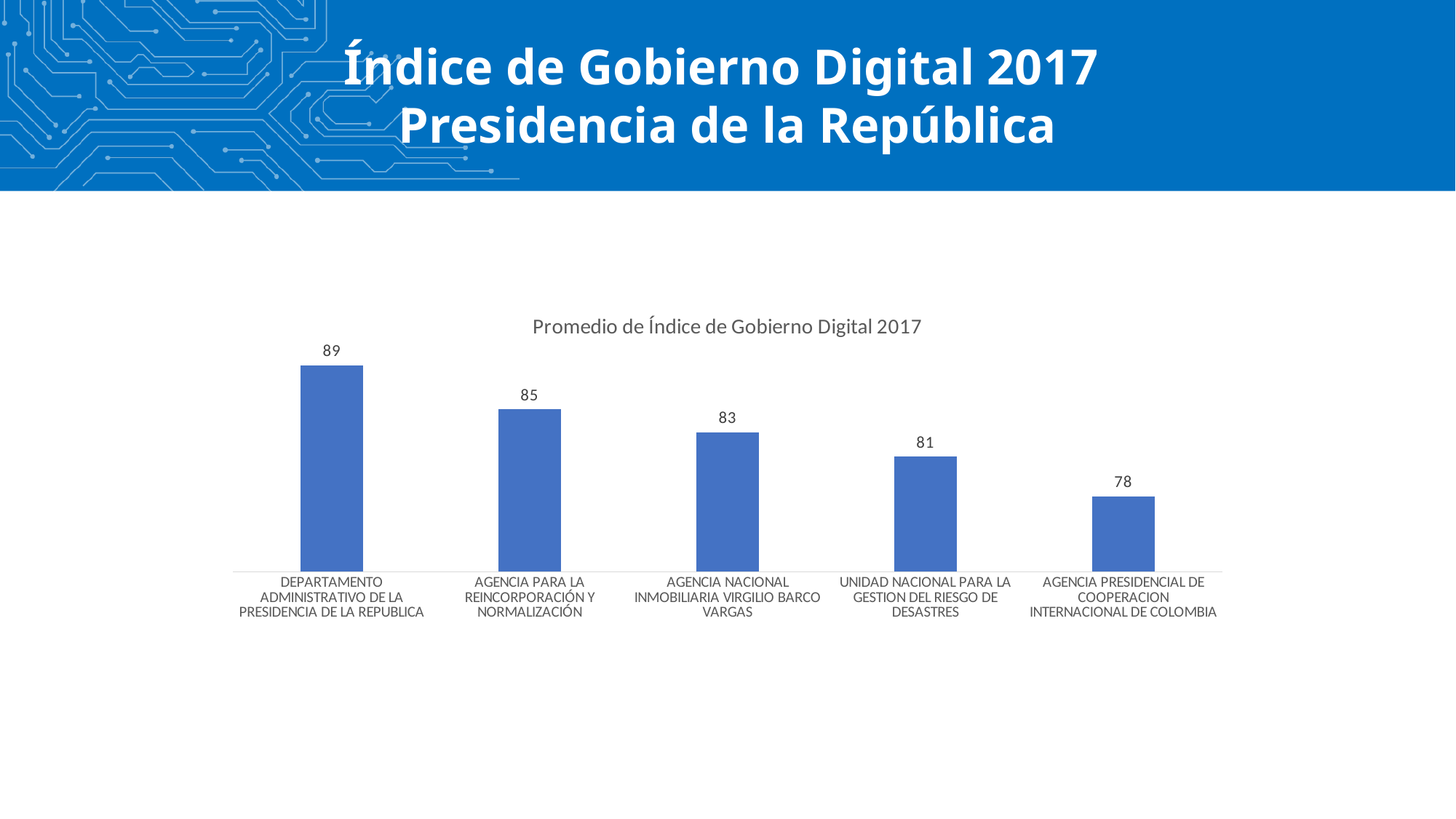
Which is larger, the value for AGENCIA PARA LA REINCORPORACIÓN Y NORMALIZACIÓN or the value for UNIDAD NACIONAL PARA LA GESTION DEL RIESGO DE DESASTRES? AGENCIA PARA LA REINCORPORACIÓN Y NORMALIZACIÓN What is the value for AGENCIA PARA LA REINCORPORACIÓN Y NORMALIZACIÓN? 85 What kind of chart is shown on the slide? Bar chart What is the difference between the values for DEPARTAMENTO ADMINISTRATIVO DE LA PRESIDENCIA DE LA REPUBLICA and AGENCIA PRESIDENCIAL DE COOPERACION INTERNACIONAL DE COLOMBIA? 11 What is the value for UNIDAD NACIONAL PARA LA GESTION DEL RIESGO DE DESASTRES? 81 What is the value for AGENCIA NACIONAL INMOBILIARIA VIRGILIO BARCO VARGAS? 83 What is the value for DEPARTAMENTO ADMINISTRATIVO DE LA PRESIDENCIA DE LA REPUBLICA? 89 What is the title of the chart? Promedio de Índice de Gobierno Digital 2017 Which category has the lowest value? AGENCIA PRESIDENCIAL DE COOPERACION INTERNACIONAL DE COLOMBIA What is the value for AGENCIA PRESIDENCIAL DE COOPERACION INTERNACIONAL DE COLOMBIA? 78 How many categories are shown in the chart? 5 Which category has the highest value? DEPARTAMENTO ADMINISTRATIVO DE LA PRESIDENCIA DE LA REPUBLICA